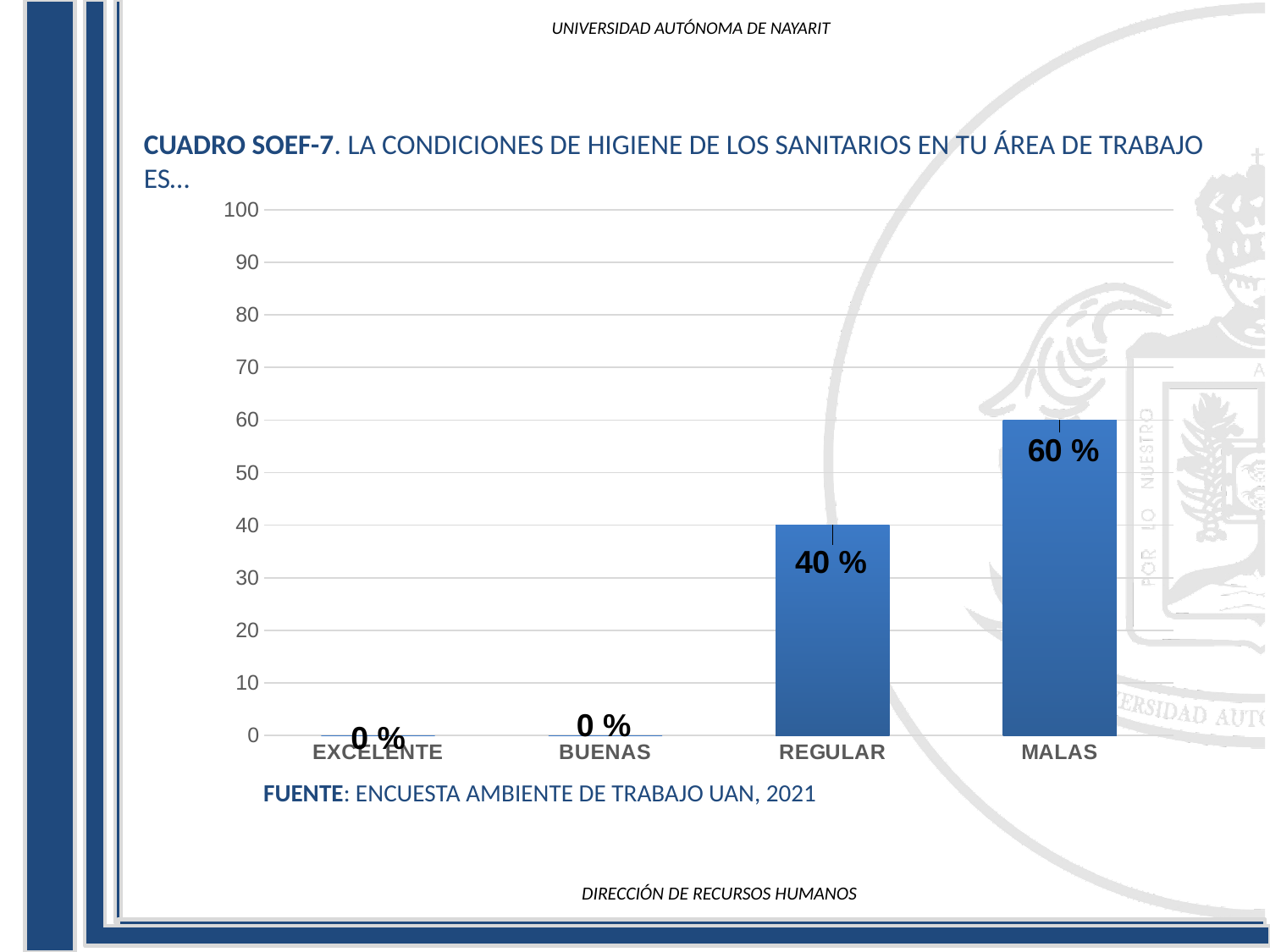
What is the value for REGULAR? 40 % What is the difference between the values for MALAS and REGULAR? 20 % How many categories are shown on the x axis? 4 What is the value for BUENAS? 0 % What is the value for MALAS? 60 % What is the value for EXCELENTE? 0 % Which category has the highest value? MALAS What kind of chart is shown on the slide? bar chart What is the source cited below the chart? ENCUESTA AMBIENTE DE TRABAJO UAN, 2021 Which is larger, the value for REGULAR or the value for MALAS? MALAS Is the value for MALAS greater or less than 50? greater Do the values rise or fall from EXCELENTE to MALAS along the x axis? rise